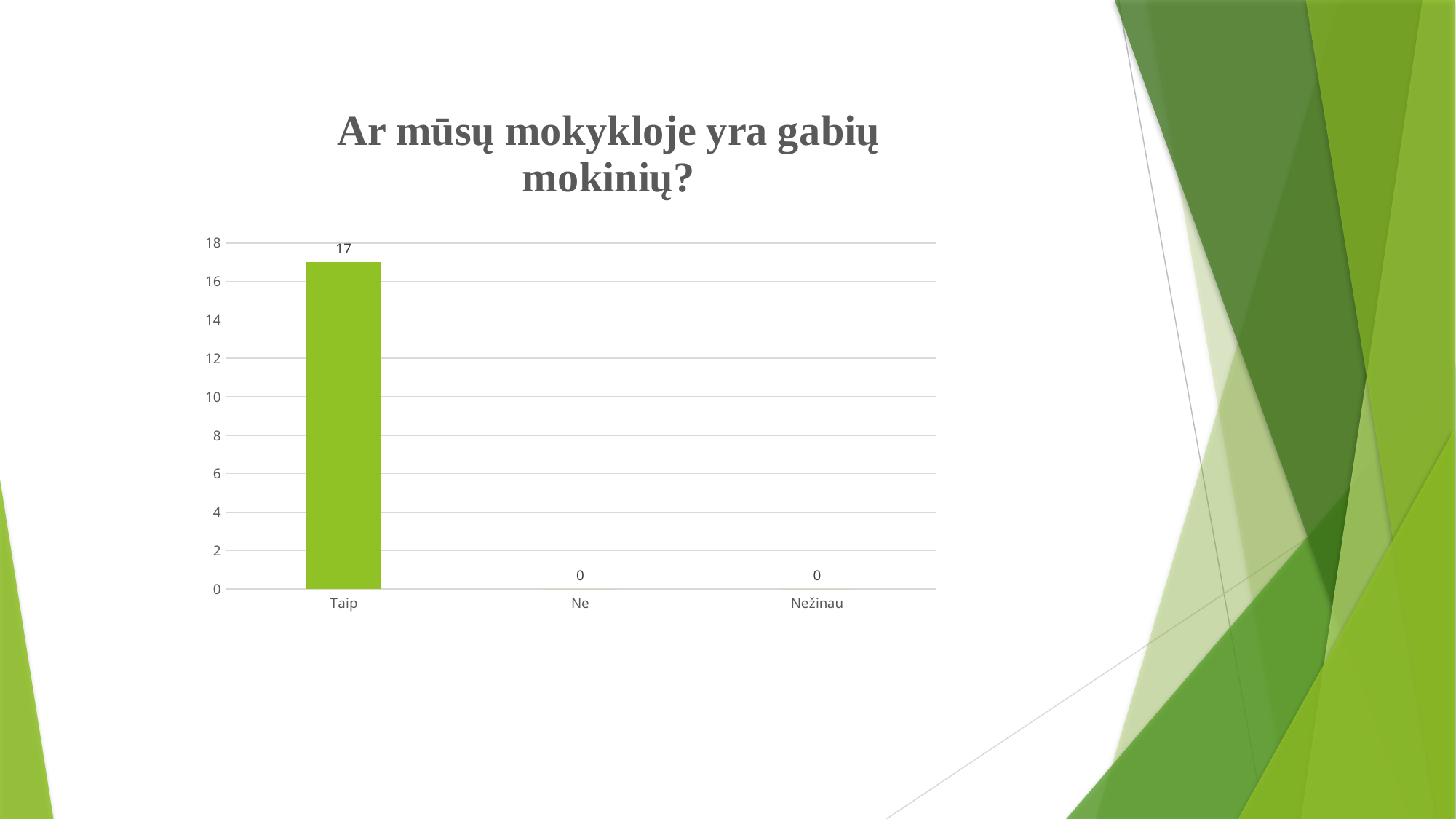
What is the value for Taip? 17 Is the value for Taip greater or less than 16? greater How many categories are shown on the x axis? 3 What is the value for Ne? 0 What is the total of the values for Taip, Ne and Nežinau? 17 What is the difference between the values for Taip and Ne? 17 What colour is the bar for Taip? green Which category has the highest value? Taip What is the value for Nežinau? 0 What is the title of the chart? Ar mūsų mokykloje yra gabių mokinių? What kind of chart is shown on the slide? bar chart Which is larger, the value for Taip or the value for Nežinau? Taip